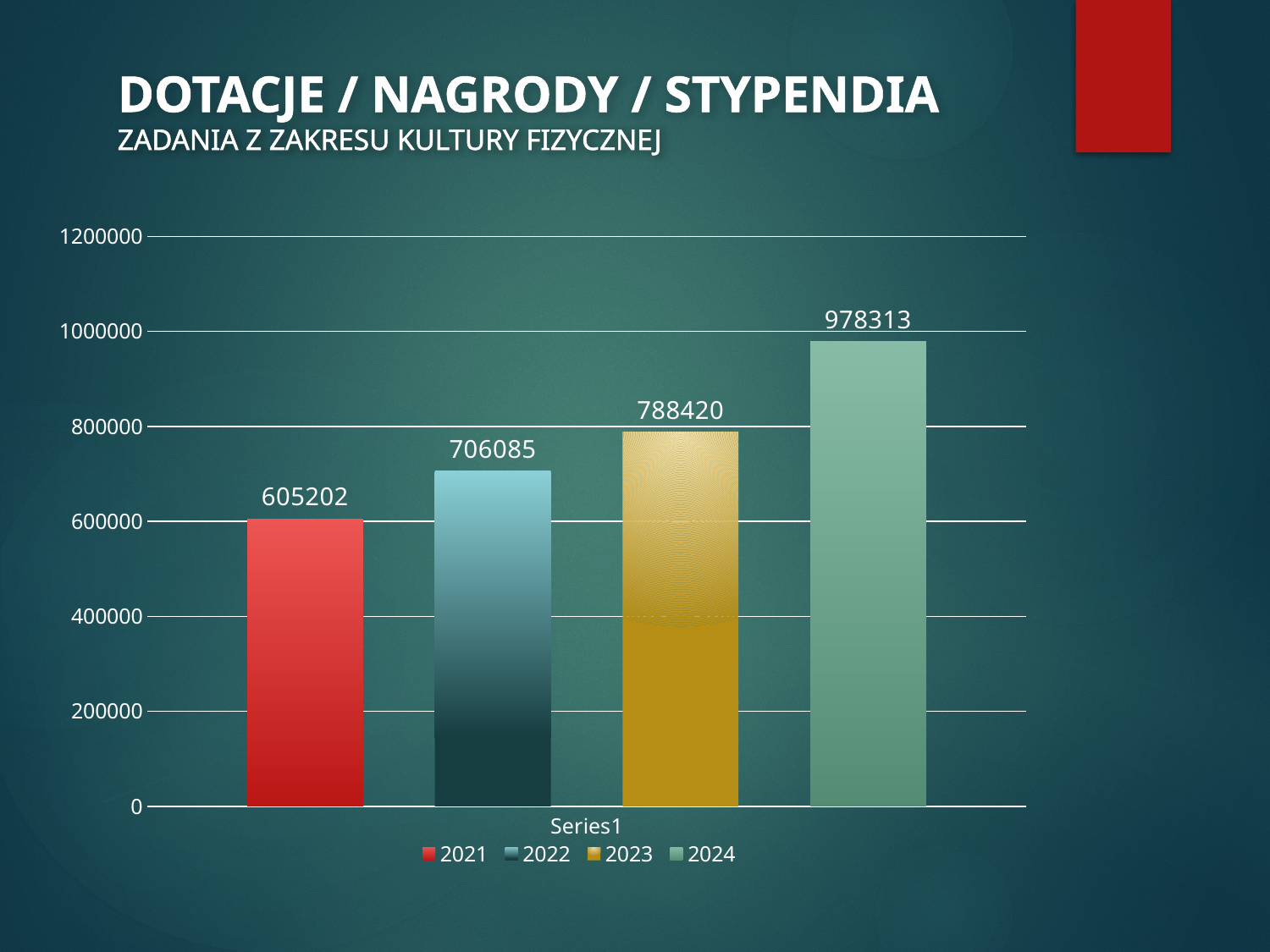
What kind of chart is shown on the slide? bar chart What is the difference between the values for 2024 and 2021? 373111 What is the value for 2021? 605202 Which is larger, the value for 2022 or the value for 2023? 2023 What is the value for 2023? 788420 What is the value for 2024? 978313 What is the difference between the values for 2023 and 2022? 82335 Which year has the highest value? 2024 Which year has the lowest value? 2021 Is the value for 2024 greater or less than 1000000? less Do the values rise or fall from 2021 to 2024? rise How many series does the legend list? 4